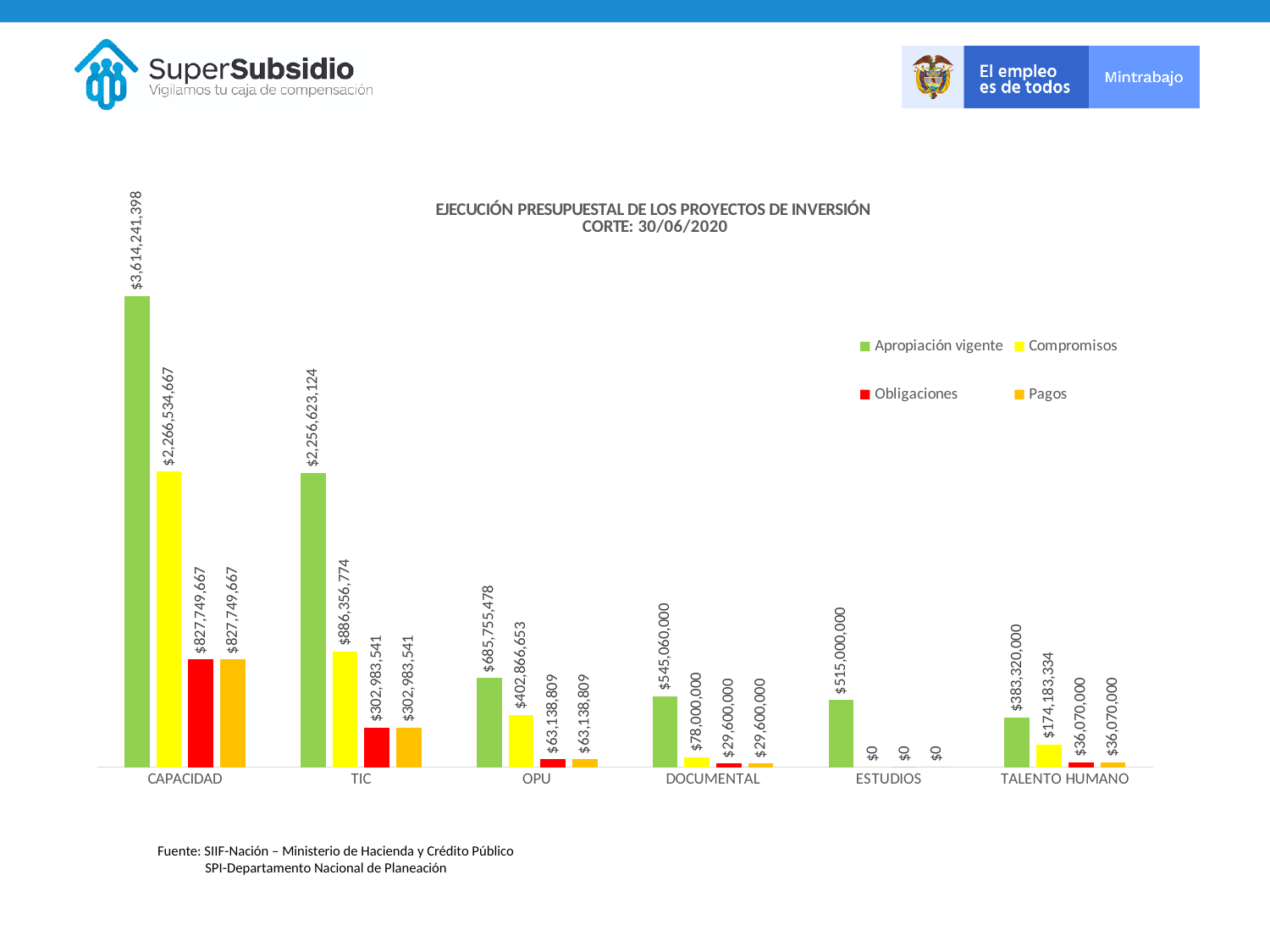
How many series does the legend list? 4 Which category has the highest Apropiación vigente? CAPACIDAD How many categories are shown on the x axis? 6 What type of chart is shown? Bar chart What is the difference between Apropiación vigente and Compromisos for CAPACIDAD? $1,347,706,731 Which is larger: the Compromisos value for OPU or the Compromisos value for TALENTO HUMANO? OPU What is the Pagos value for OPU? $63,138,809 Which category has the lowest Apropiación vigente? TALENTO HUMANO What is the Compromisos value for TIC? $886,356,774 What is the Compromisos value for ESTUDIOS? $0 What is the Apropiación vigente value for CAPACIDAD? $3,614,241,398 What is the Obligaciones value for DOCUMENTAL? $29,600,000